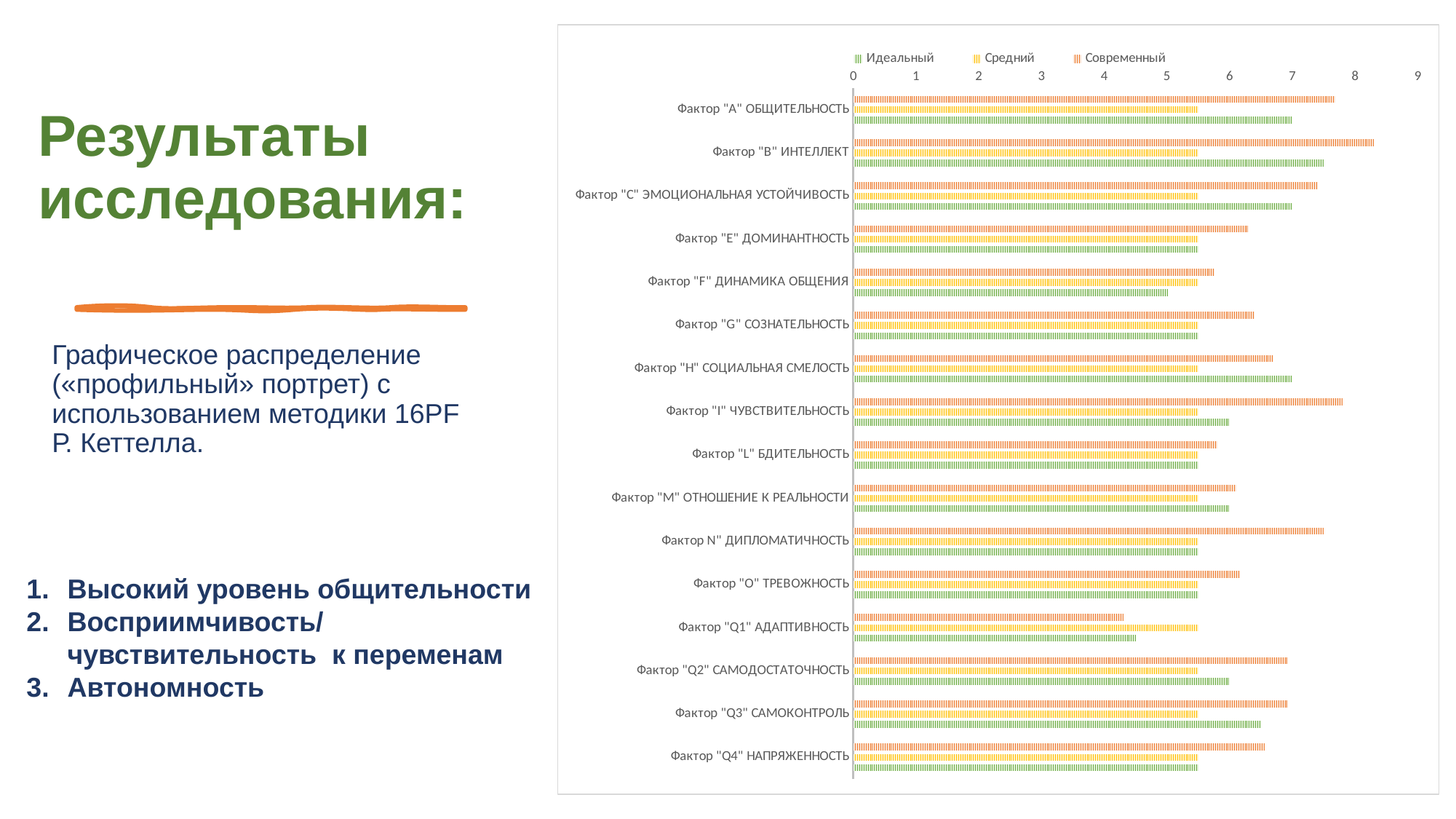
Which factor has the lowest value for the "Идеальный" series? Фактор "Q1" АДАПТИВНОСТЬ How many factors (categories) are plotted on the chart? 16 Is the "Современный" value for Фактор "B" ИНТЕЛЛЕКТ greater or less than 8? greater Which factor has the highest value for the "Современный" series? Фактор "B" ИНТЕЛЛЕКТ Which factor has the lowest value for the "Современный" series? Фактор "Q1" АДАПТИВНОСТЬ What are the three series names listed in the chart legend? Идеальный, Средний, Современный For Фактор "A" ОБЩИТЕЛЬНОСТЬ, which series has the larger value: "Современный" or "Средний"? Современный Is the "Современный" value for Фактор "Q1" АДАПТИВНОСТЬ greater or less than 5? less Is the "Средний" value for Фактор "A" ОБЩИТЕЛЬНОСТЬ greater or less than 6? less How many series does the chart legend list? 3 For Фактор "I" ЧУВСТВИТЕЛЬНОСТЬ, which series has the larger value: "Современный" or "Идеальный"? Современный What kind of chart is shown on the slide? Bar chart